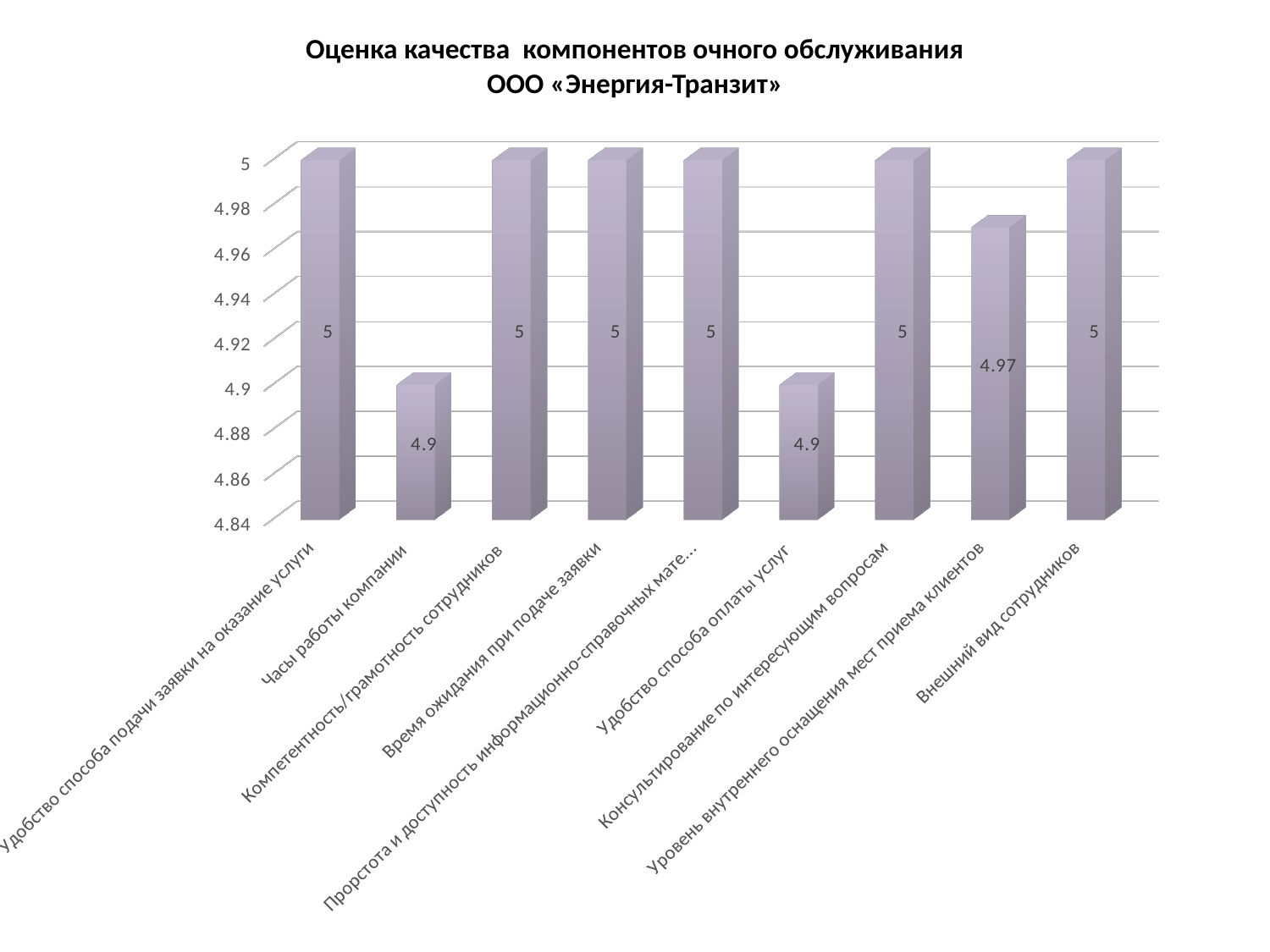
What is the value for "Уровень внутреннего оснащения мест приема клиентов"? 4.97 What is the value for "Компетентность/грамотность сотрудников"? 5 Which is larger: the value for "Консультирование по интересующим вопросам" or the value for "Уровень внутреннего оснащения мест приема клиентов"? Консультирование по интересующим вопросам How many categories have a value of 5? 6 What is the difference between the value for "Уровень внутреннего оснащения мест приема клиентов" and the value for "Часы работы компании"? 0.07 Is the value for "Уровень внутреннего оснащения мест приема клиентов" greater or less than 4.94? greater What is the value for "Внешний вид сотрудников"? 5 What type of chart is shown on the slide? Bar chart What is the title of the chart? Оценка качества компонентов очного обслуживания ООО «Энергия-Транзит» What is the value for "Часы работы компании"? 4.9 How many categories are plotted in the chart? 9 What is the value for "Удобство способа оплаты услуг"? 4.9